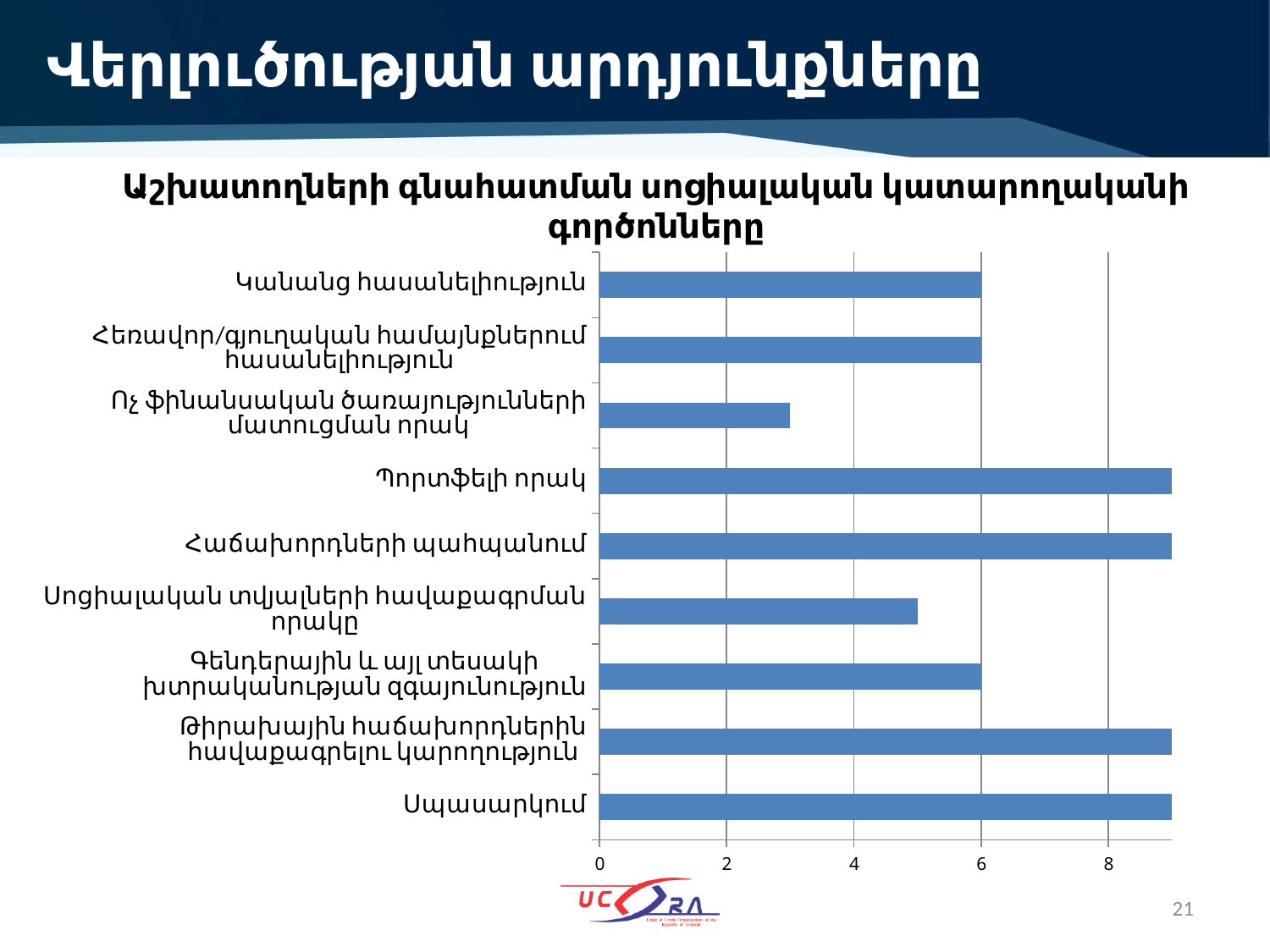
What is the value for Հեռավոր/գյուղական համայնքներում հասանելիություն? 6 What is the value for Գենդերային և այլ տեսակի խտրականության զգայունություն? 6 Is the value for Սոցիալական տվյալների հավաքագրման որակը greater or less than 6? less What is the title of the chart? Աշխատողների գնահատման սոցիալական կատարողականի գործոնները Which category has the lowest value? Ոչ ֆինանսական ծառայությունների մատուցման որակ Is the value for Ոչ ֆինանսական ծառայությունների մատուցման որակ greater or less than 4? less Which has a larger value: Հաճախորդների պահպանում or Ոչ ֆինանսական ծառայությունների մատուցման որակ? Հաճախորդների պահպանում What is the value for Կանանց հասանելիություն? 6 Which has a larger value: Սպասարկում or Սոցիալական տվյալների հավաքագրման որակը? Սպասարկում How many categories are plotted in the chart? 9 What type of chart is shown on the slide? bar chart Is the value for Պորտֆելի որակ greater or less than 8? greater